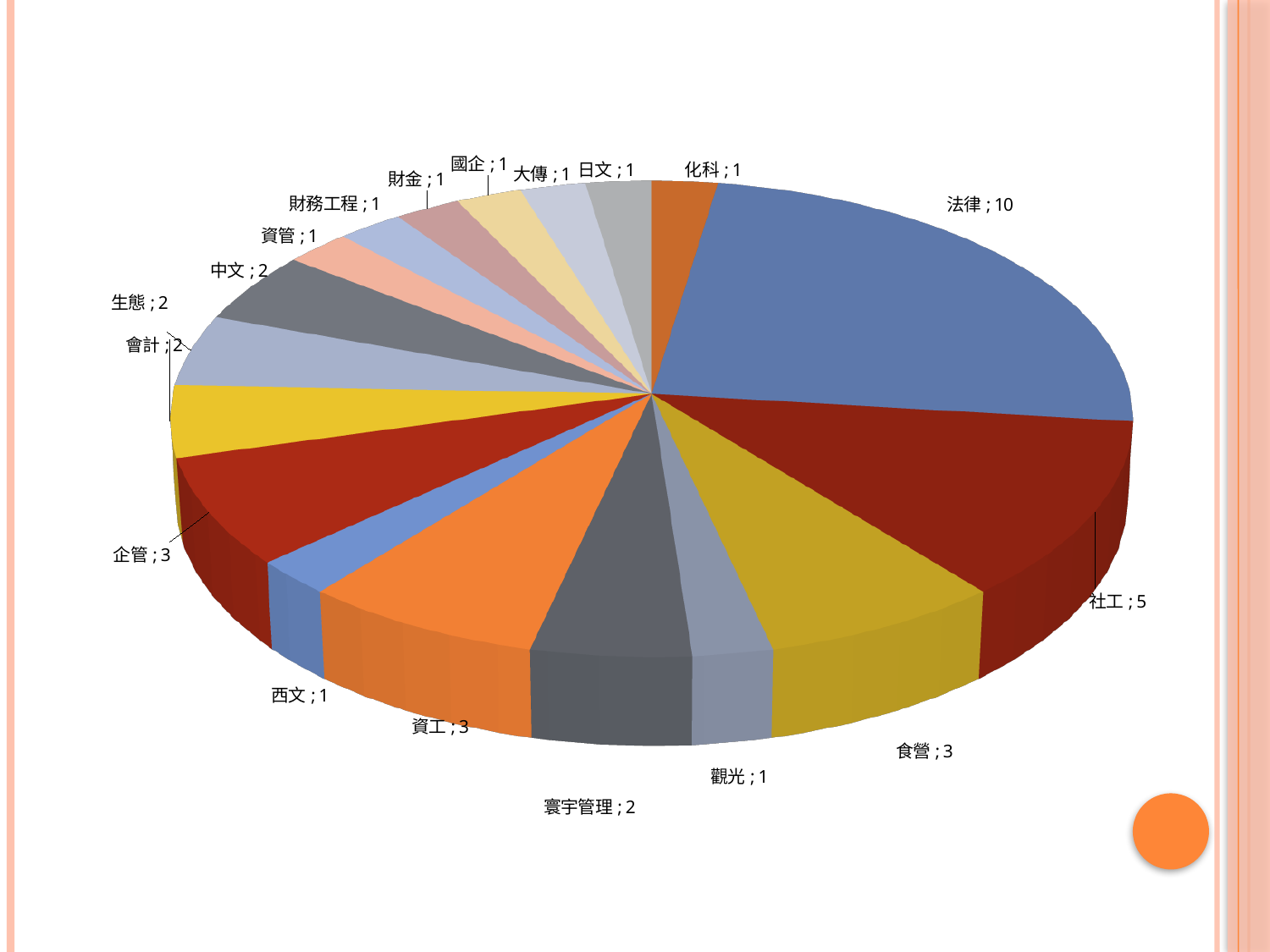
What kind of chart is shown on the slide? pie chart Which is larger, the value for 食營 or the value for 觀光? 食營 What is the difference between the values for 資工 and 西文? 2 What is the value for 財務工程? 1 Which category has the largest slice? 法律 How many categories are shown in the pie chart? 18 What is the value for 法律? 10 What is the value for 寰宇管理? 2 Which is larger, the value for 企管 or the value for 會計? 企管 What is the difference between the values for 法律 and 社工? 5 What is the value for 社工? 5